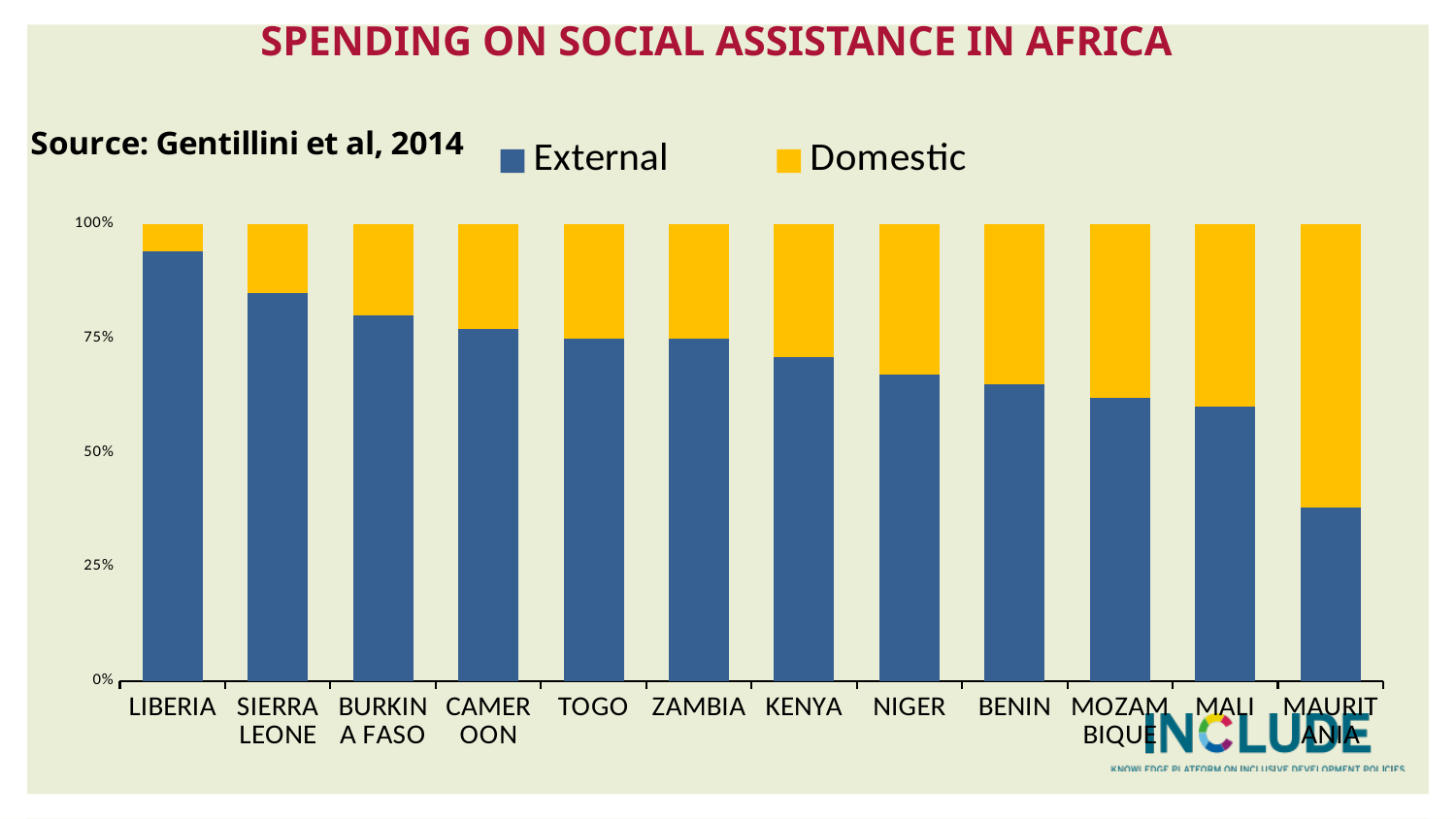
Which country has a larger External share, Sierra Leone or Niger? Sierra Leone Which country has the largest External share of social assistance spending? Liberia How many series does the chart's legend list? 2 Is the External value for Liberia greater or less than 75%? greater Is the External value for Mali greater or less than 50%? greater Which country has the largest Domestic share of social assistance spending? Mauritania Does the External share rise or fall moving from left to right along the x axis? Fall How many countries are shown on the x axis of the chart? 12 Is the External value for Mauritania greater or less than 50%? less Which country has the smallest External share of social assistance spending? Mauritania What is the title of the chart on the slide? SPENDING ON SOCIAL ASSISTANCE IN AFRICA What kind of chart is shown on the slide? Stacked bar chart